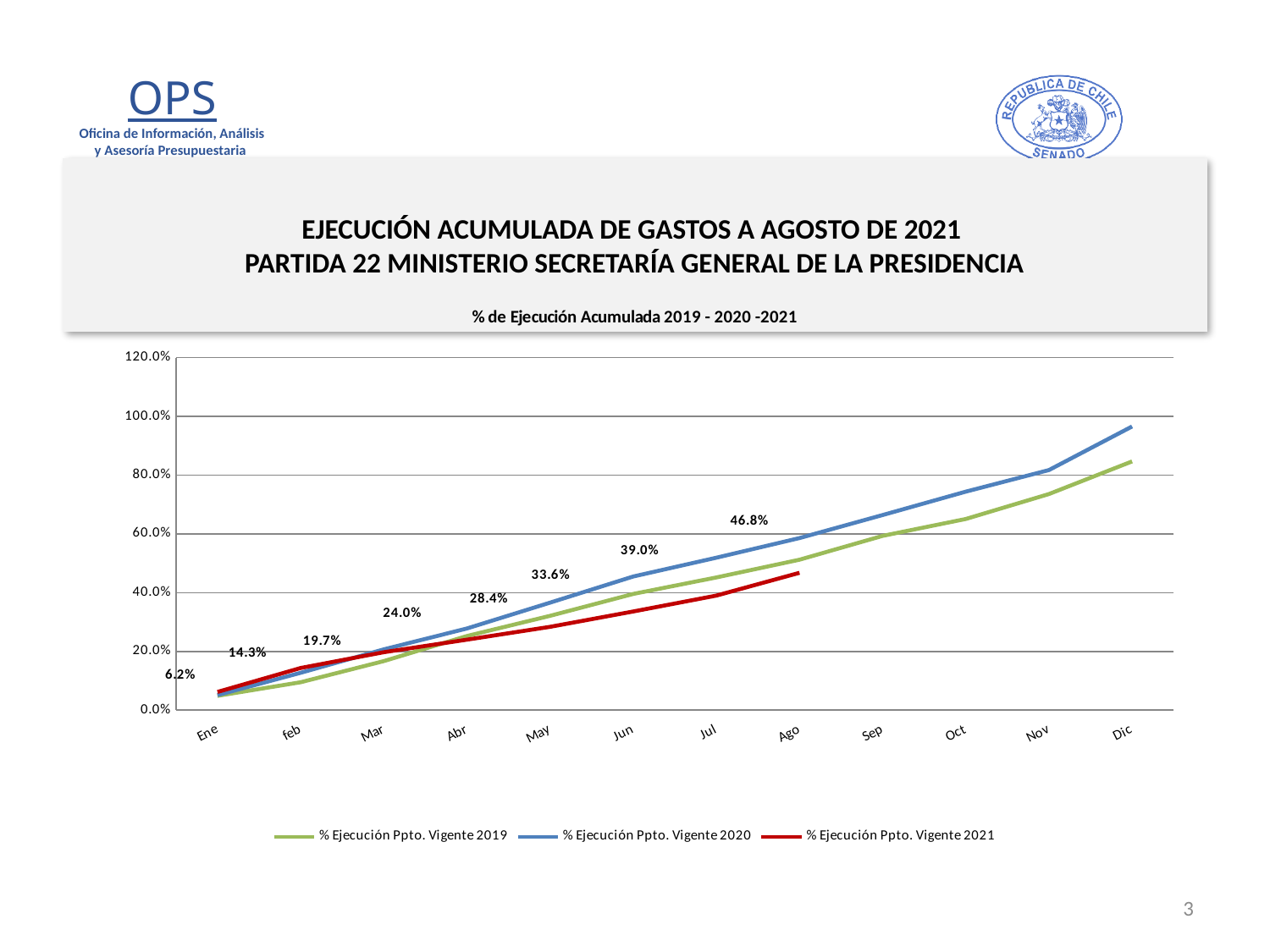
What is the value of % Ejecución Ppto. Vigente 2021 in May? 28.4% Is the value for % Ejecución Ppto. Vigente 2020 in Dic greater or less than 80.0%? greater What type of chart is shown on the slide? line chart What is the difference between the % Ejecución Ppto. Vigente 2021 values for Ago and Jul? 7.8% How many series does the legend list? 3 Does the % Ejecución Ppto. Vigente 2021 series rise or fall from Ene to Ago? rise What is the difference between the % Ejecución Ppto. Vigente 2021 values for Abr and Mar? 4.3% What is the value of % Ejecución Ppto. Vigente 2021 in Ene? 6.2% What is the chart's title? % de Ejecución Acumulada 2019 - 2020 -2021 How many months are shown on the x axis? 12 In Ago, which series is larger: % Ejecución Ppto. Vigente 2020 or % Ejecución Ppto. Vigente 2021? % Ejecución Ppto. Vigente 2020 What is the value of % Ejecución Ppto. Vigente 2021 in Ago? 46.8%